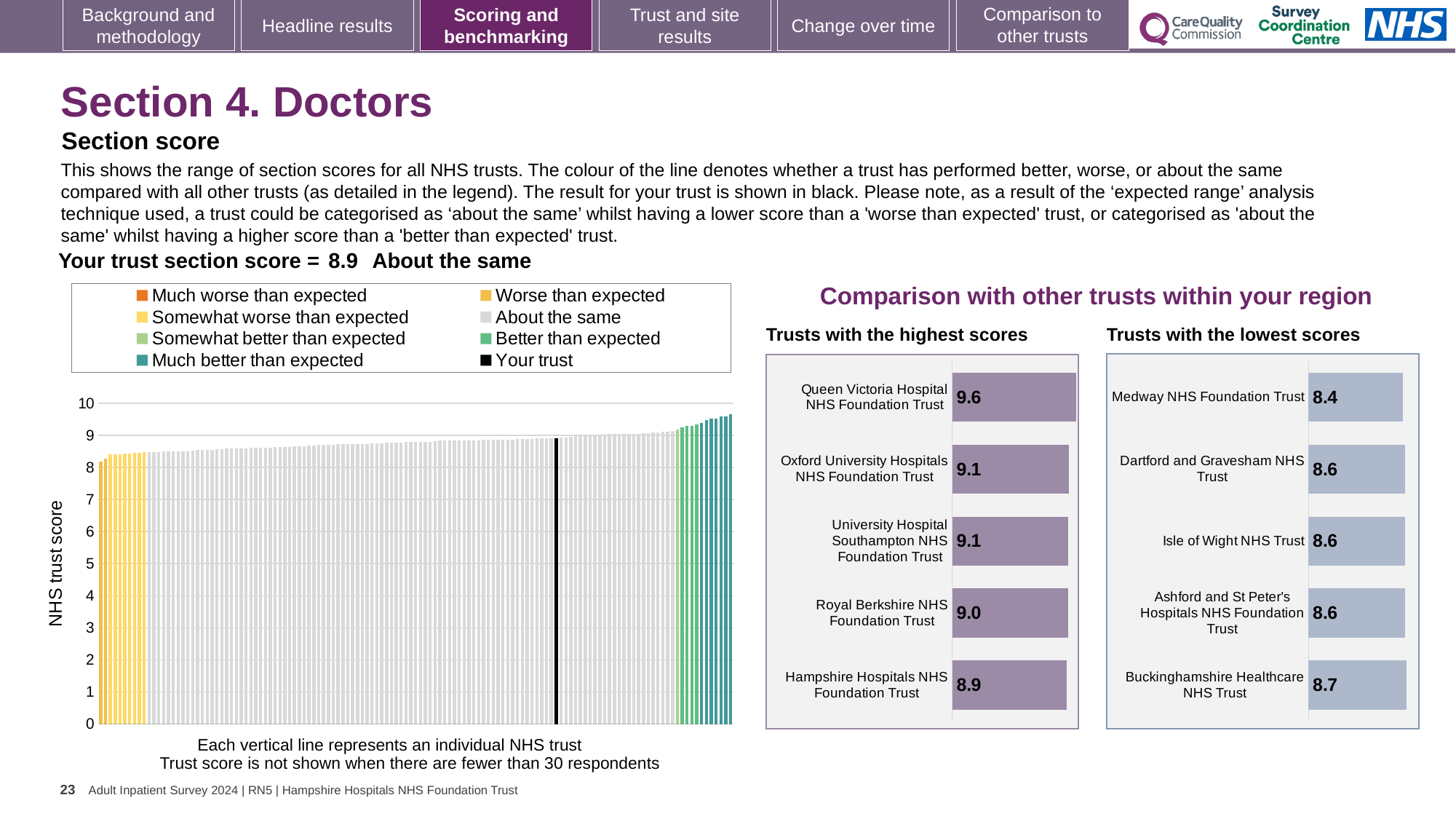
How many entries does the legend of the NHS trust score chart on the left list? 8 In the 'Trusts with the lowest scores' chart, what is the score for Medway NHS Foundation Trust? 8.4 In the 'Trusts with the highest scores' chart, which trust has the highest score? Queen Victoria Hospital NHS Foundation Trust How many trusts are shown in the 'Trusts with the highest scores' chart? 5 In the 'Trusts with the highest scores' chart, what is the score for Queen Victoria Hospital NHS Foundation Trust? 9.6 What kind of chart is the 'Trusts with the lowest scores' chart? Bar chart In the 'Trusts with the lowest scores' chart, what is the score for Buckinghamshire Healthcare NHS Trust? 8.7 In the NHS trust score chart on the left, do the trust scores rise or fall from left to right along the x axis? Rise In the NHS trust score chart on the left, is the value for the black 'Your trust' line greater or less than 5? greater In the 'Trusts with the highest scores' chart, what is the difference between the scores of Queen Victoria Hospital NHS Foundation Trust and Hampshire Hospitals NHS Foundation Trust? 0.7 Which has the higher score: Royal Berkshire NHS Foundation Trust in the highest scores chart or Buckinghamshire Healthcare NHS Trust in the lowest scores chart? Royal Berkshire NHS Foundation Trust In the 'Trusts with the lowest scores' chart, which trust has the lowest score? Medway NHS Foundation Trust